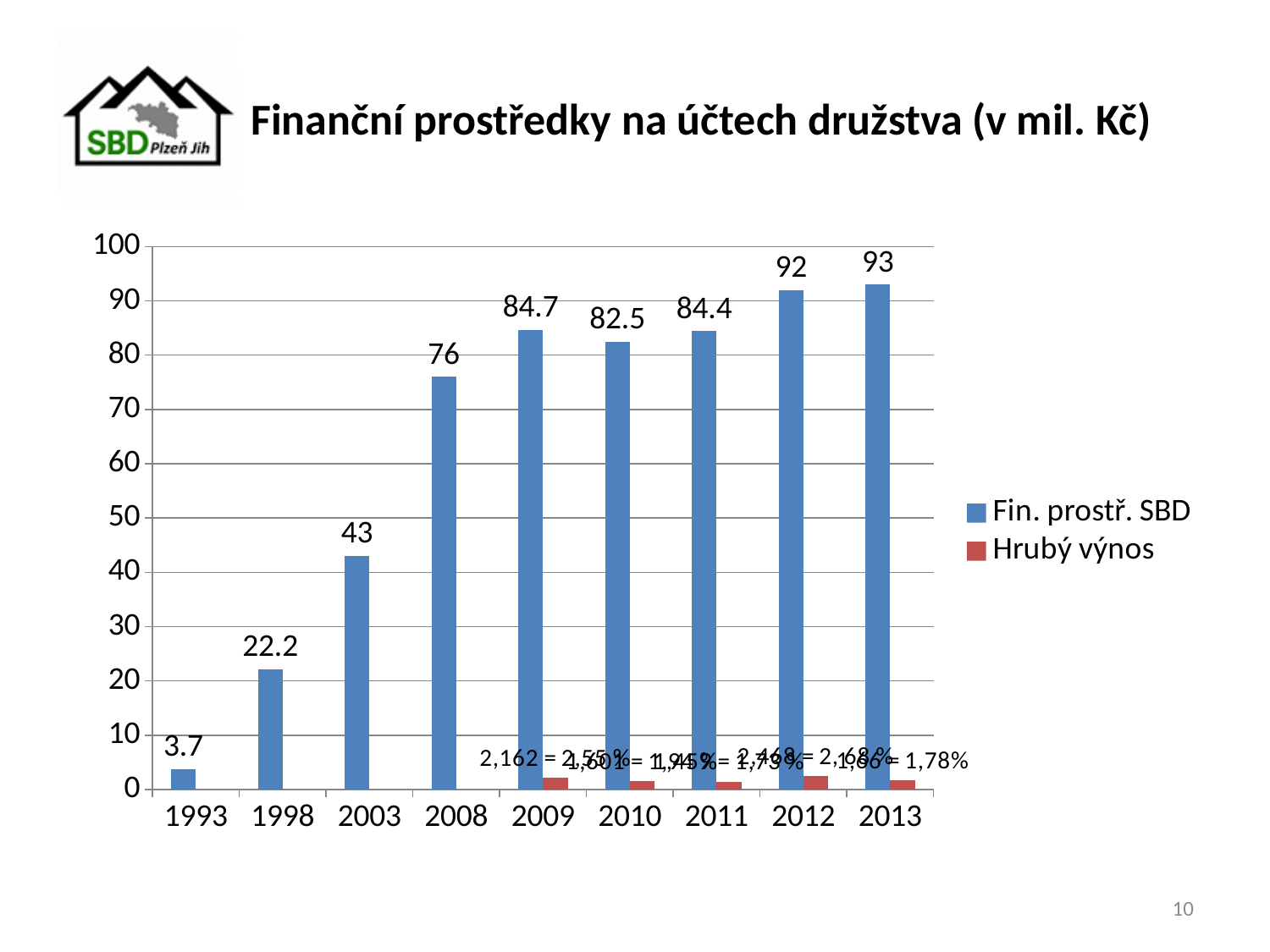
Which year has the highest value for Fin. prostř. SBD? 2013 What is the value of Fin. prostř. SBD for 2013? 93 What kind of chart is shown on the slide? bar chart What is the value of Fin. prostř. SBD for 1998? 22.2 How many years are shown on the x axis? 9 How many series does the legend list? 2 Which year has the lowest value for Fin. prostř. SBD? 1993 What is the value of Fin. prostř. SBD for 2010? 82.5 What is the difference between the Fin. prostř. SBD values for 2013 and 1993? 89.3 Is the value of Fin. prostř. SBD for 2003 greater or less than 50? less What is the value of Fin. prostř. SBD for 2008? 76 Which is larger, the Fin. prostř. SBD value for 2009 or for 2010? 2009